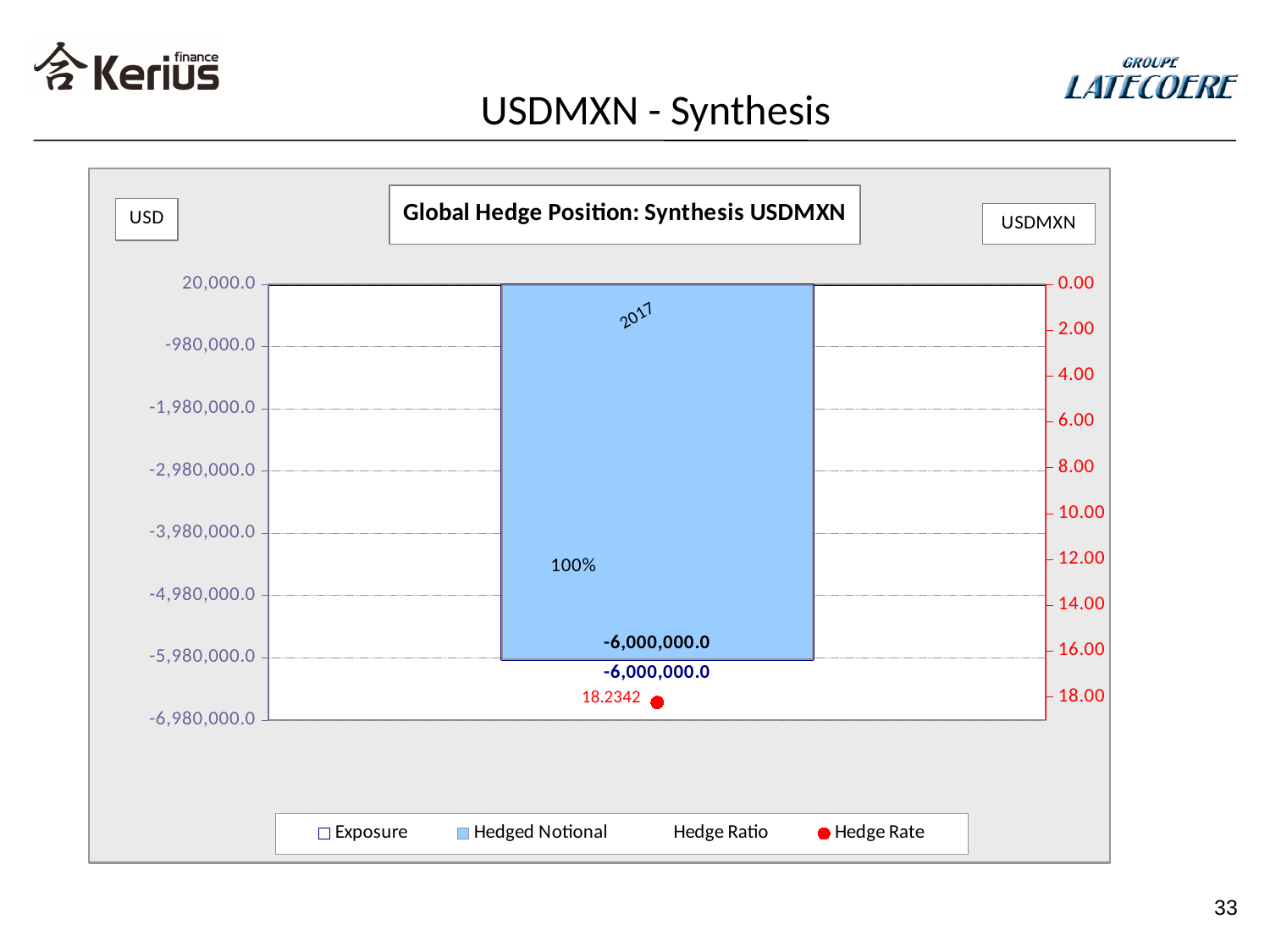
What is the title of the chart? Global Hedge Position: Synthesis USDMXN What kind of chart is used to show the Hedged Notional? bar chart How many series does the chart legend list? 4 What is the Exposure value labelled for 2017? -6,000,000.0 What is the difference between the Exposure and the Hedged Notional for 2017? 0.0 How many categories are plotted on the x axis of the chart? 1 What colour is the Hedge Rate marker in the chart? red Which year is shown as the category on the chart? 2017 What is the Hedged Notional value labelled for 2017? -6,000,000.0 What is the Hedge Rate value labelled for 2017? 18.2342 Is the Hedge Rate for 2017 greater or less than 16.00 on the right-hand axis? greater What is the Hedge Ratio labelled for 2017? 100%